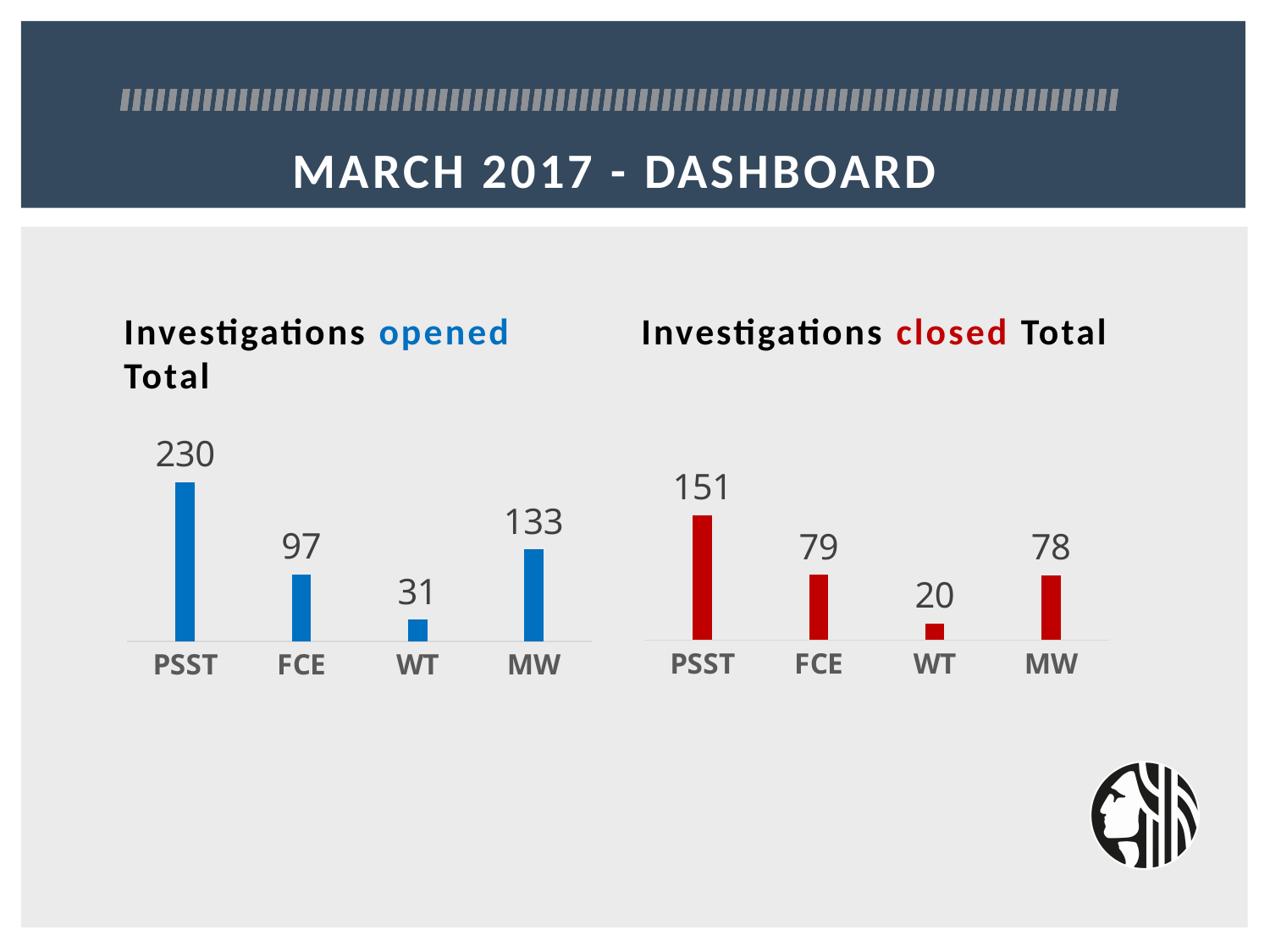
In the 'Investigations opened Total' chart, which is larger, the value for FCE or the value for MW? MW In the 'Investigations opened Total' chart, which category has the lowest value? WT In the 'Investigations closed Total' chart, what is the value for MW? 78 How many categories are shown in the 'Investigations closed Total' chart? 4 In the 'Investigations opened Total' chart, what is the difference between the values for PSST and MW? 97 What colour are the bars in the 'Investigations closed Total' chart? Red In the 'Investigations closed Total' chart, what is the value for WT? 20 In the 'Investigations opened Total' chart, what is the value for FCE? 97 In the 'Investigations opened Total' chart, what is the value for PSST? 230 In the 'Investigations closed Total' chart, what is the difference between the values for FCE and WT? 59 What kind of chart is the 'Investigations opened Total' chart? Bar chart In the 'Investigations closed Total' chart, which category has the highest value? PSST